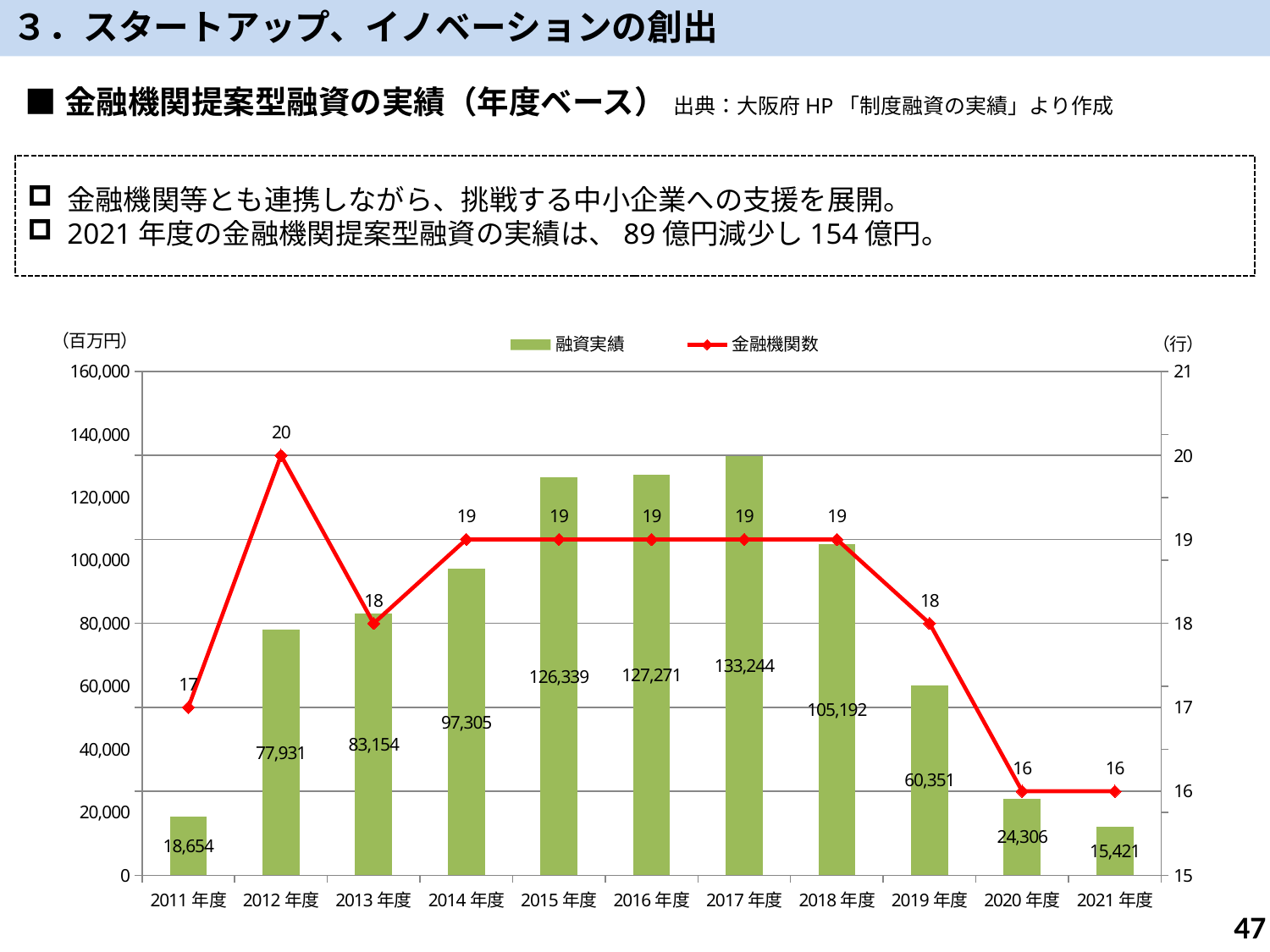
Which year has the lowest 融資実績? 2021年度 What is the 融資実績 value for 2021年度? 15,421 What is the 融資実績 value for 2015年度? 126,339 Which is larger, the 融資実績 for 2013年度 or for 2019年度? 2013年度 Which year has the highest 金融機関数? 2012年度 What is the difference in 融資実績 between 2020年度 and 2021年度? 8,885 Which year has the highest 融資実績? 2017年度 How many series does the legend list? 2 How many years are shown on the x axis? 11 What is the 金融機関数 value for 2012年度? 20 What kind of chart is this? Combined bar and line chart Does the 融資実績 rise or fall from 2017年度 to 2021年度? Fall